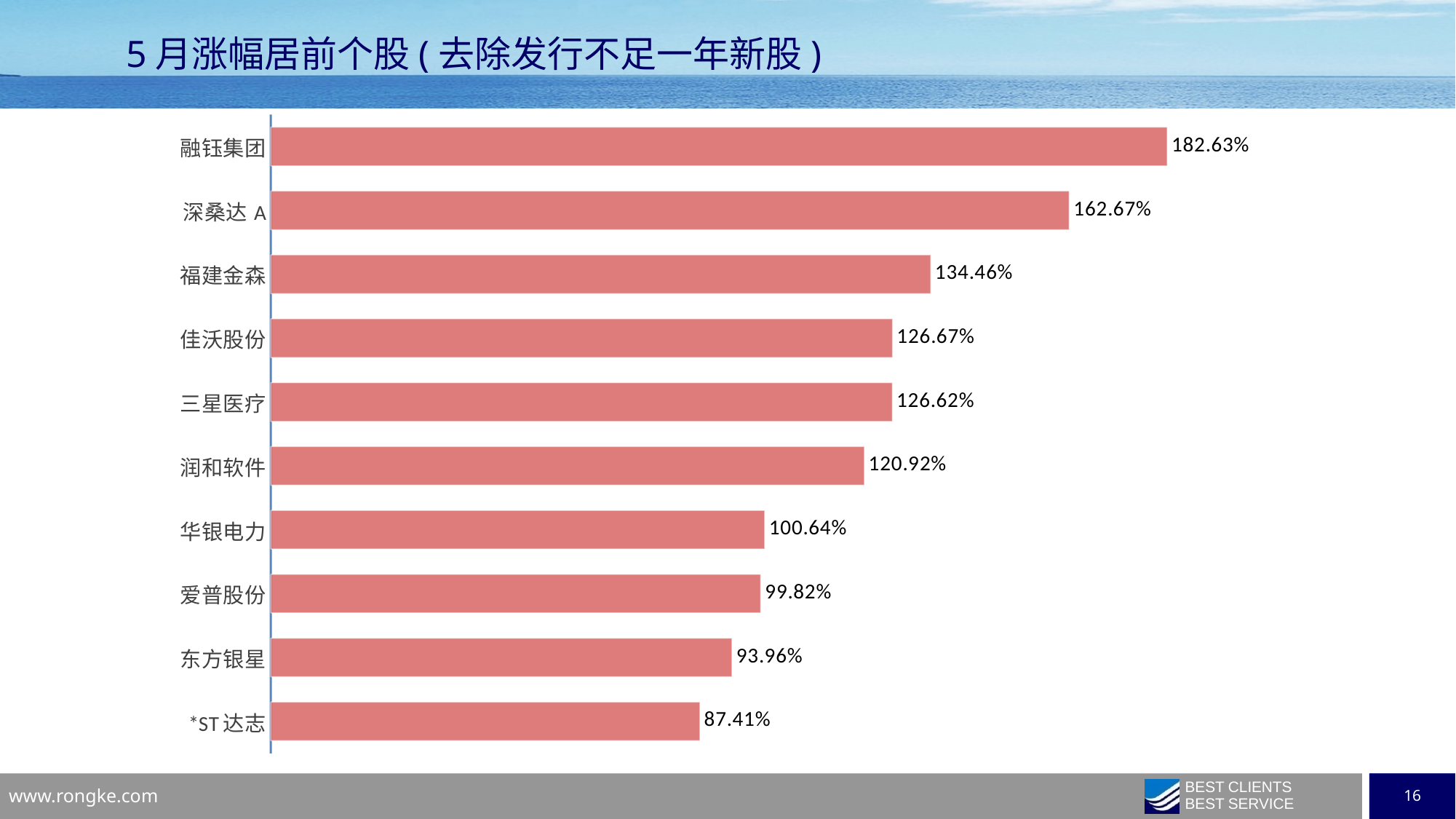
What kind of chart is shown on the slide? Bar chart What is the title of the slide? 5月涨幅居前个股（去除发行不足一年新股） What is the difference between the values for 福建金森 and 东方银星? 40.50% Which stock has the lowest value? *ST达志 What is the difference between the values for 融钰集团 and 深桑达A? 19.96% Which stock has the highest value? 融钰集团 What is the value for 融钰集团? 182.63% What is the value for *ST达志? 87.41% What is the value for 润和软件? 120.92% How many stocks are shown in the chart? 10 What is the value for 华银电力? 100.64% Which is larger, the value for 爱普股份 or the value for 东方银星? 爱普股份